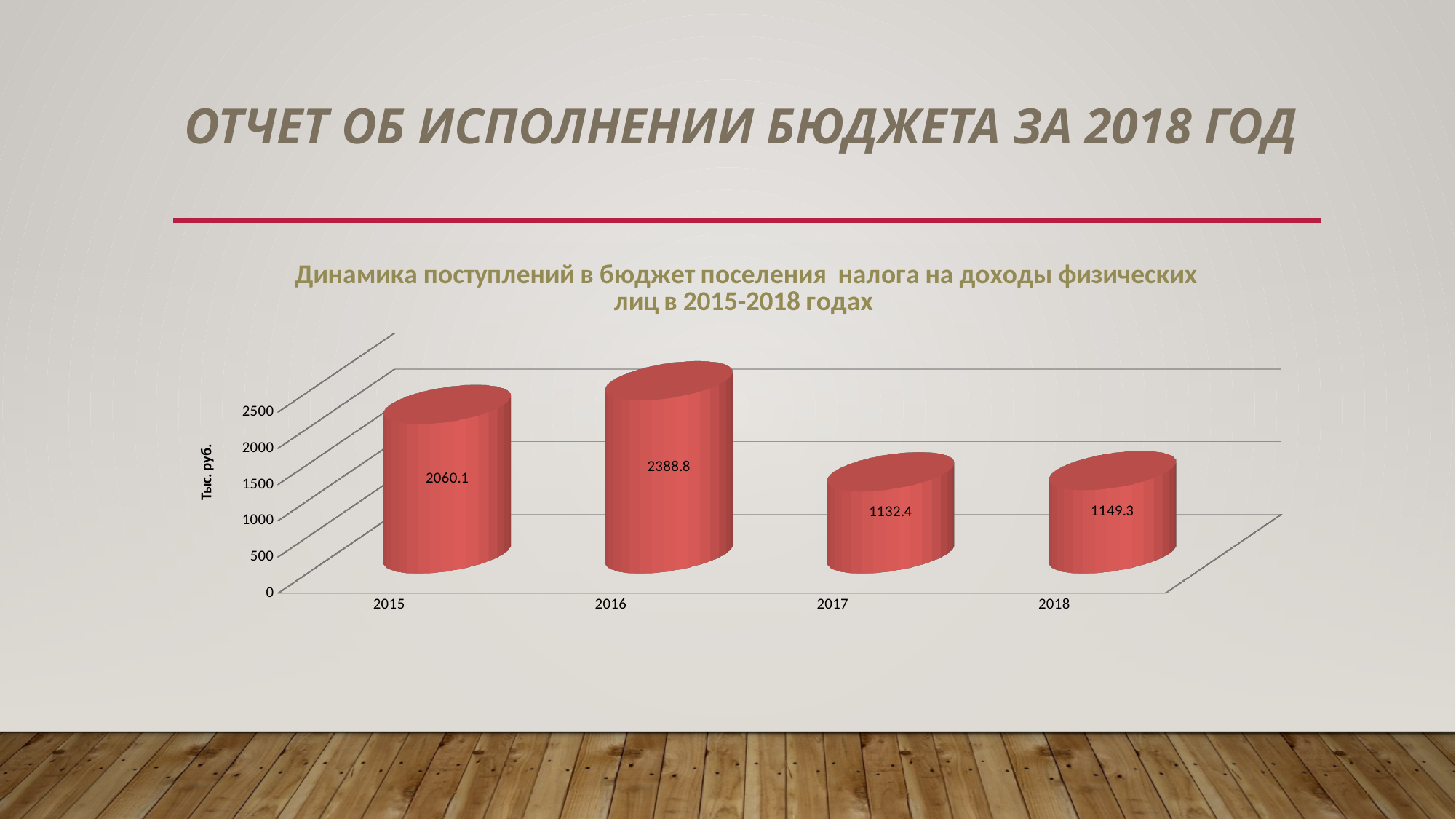
Which year has the highest value? 2016 What is the value for 2017? 1132.4 What is the difference between the values for 2018 and 2017? 16.9 How many years are shown on the x axis? 4 What is the value for 2015? 2060.1 What is the value for 2016? 2388.8 What unit is shown on the vertical axis label? Тыс. руб. What type of chart is shown on the slide? bar chart What is the difference between the values for 2016 and 2015? 328.7 Which is larger, the value for 2015 or the value for 2018? 2015 What is the value for 2018? 1149.3 Which year has the lowest value? 2017